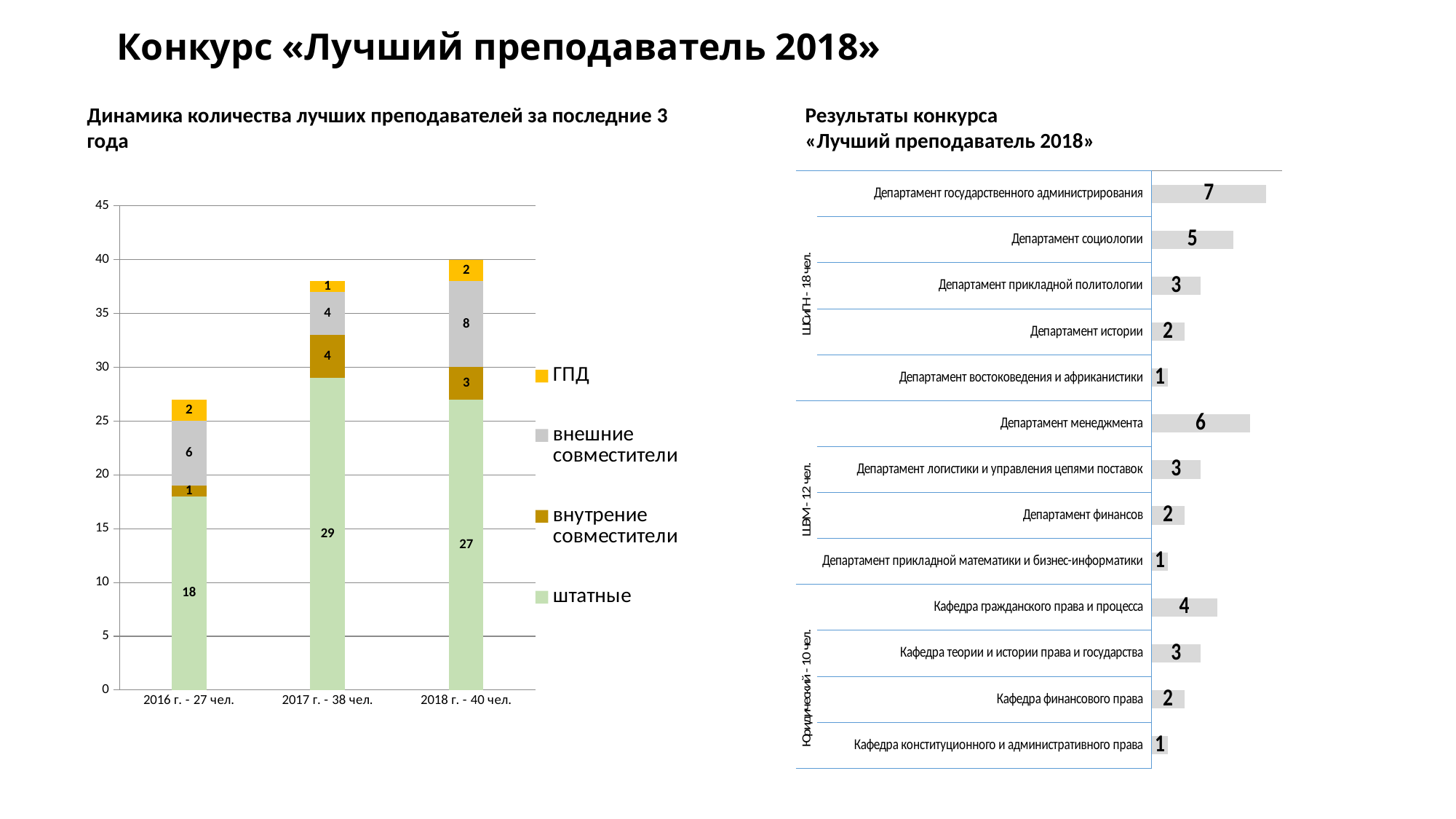
In the left chart, what kind of chart is shown? Stacked bar chart In the left chart (Динамика количества лучших преподавателей за последние 3 года), what is the value for штатные in 2017 г. - 38 чел.? 29 In the right chart, what is the difference between the values for Департамент государственного администрирования and Департамент истории? 5 In the right chart, which is larger: the value for Департамент социологии or the value for Кафедра гражданского права и процесса? Департамент социологии In the left chart, what is the total of the stacked bar for 2016 г. - 27 чел.? 27 In the left chart, what is the value for внешние совместители in 2018 г. - 40 чел.? 8 In the right chart, which department has the highest value? Департамент государственного администрирования In the right chart (Результаты конкурса «Лучший преподаватель 2018»), what is the value for Департамент менеджмента? 6 In the left chart, what is the difference between the штатные values for 2017 г. - 38 чел. and 2016 г. - 27 чел.? 11 In the right chart, how many departments/кафедры are listed? 13 In the left chart, which year has the highest value for внутрение совместители? 2017 г. - 38 чел. In the left chart, how many series does the legend list? 4